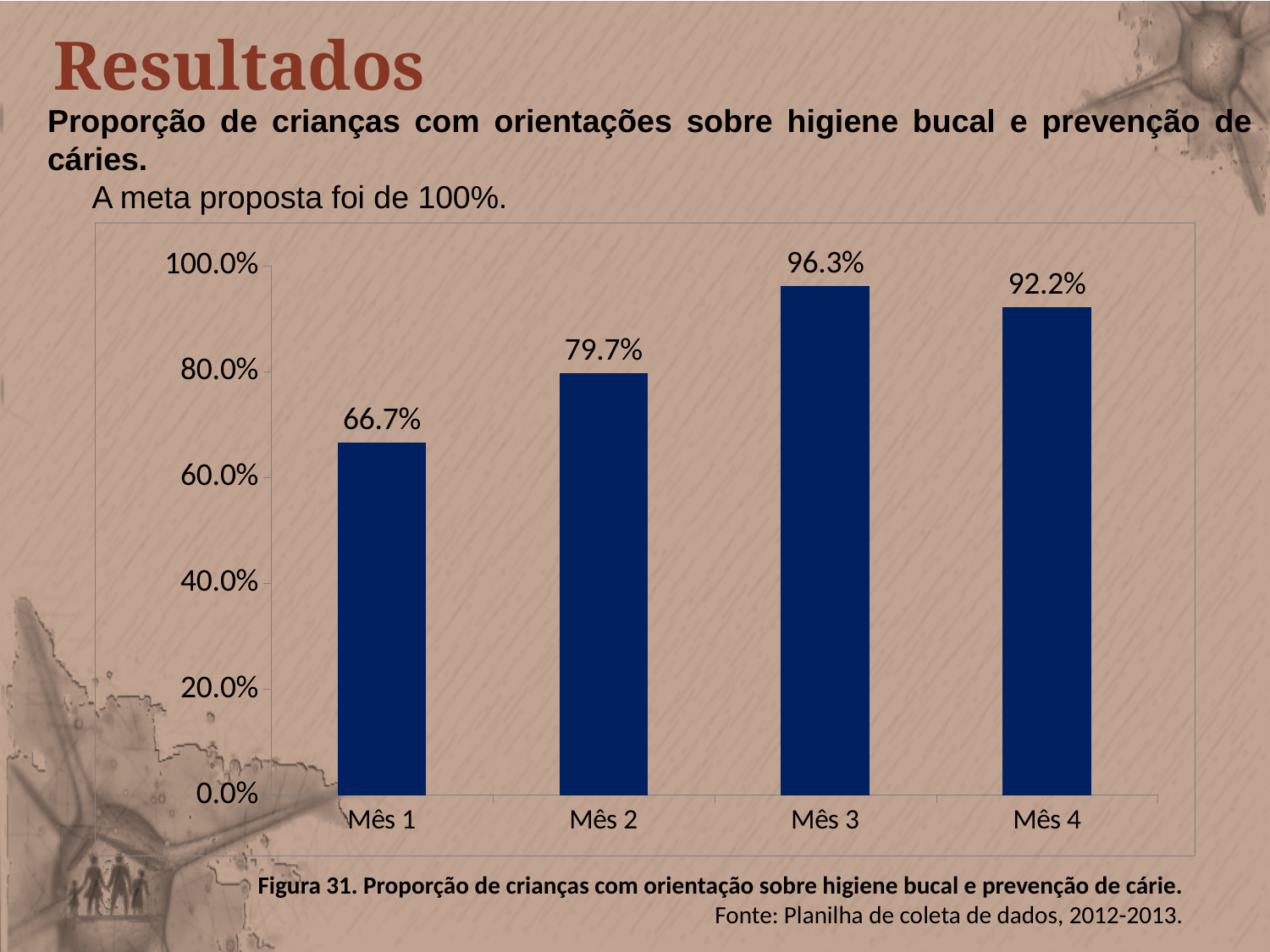
How many months are shown on the x axis? 4 Which month has the lowest value? Mês 1 What is the value for Mês 1? 66.7% What is the value for Mês 2? 79.7% What is the difference between the values for Mês 3 and Mês 1? 29.6% Which month has the highest value? Mês 3 What is the value for Mês 4? 92.2% What is the value for Mês 3? 96.3% What is the difference between the values for Mês 3 and Mês 4? 4.1% What kind of chart is shown on the slide? Bar chart Which is larger, the value for Mês 2 or the value for Mês 4? Mês 4 What is the figure number given in the caption below the chart? Figura 31